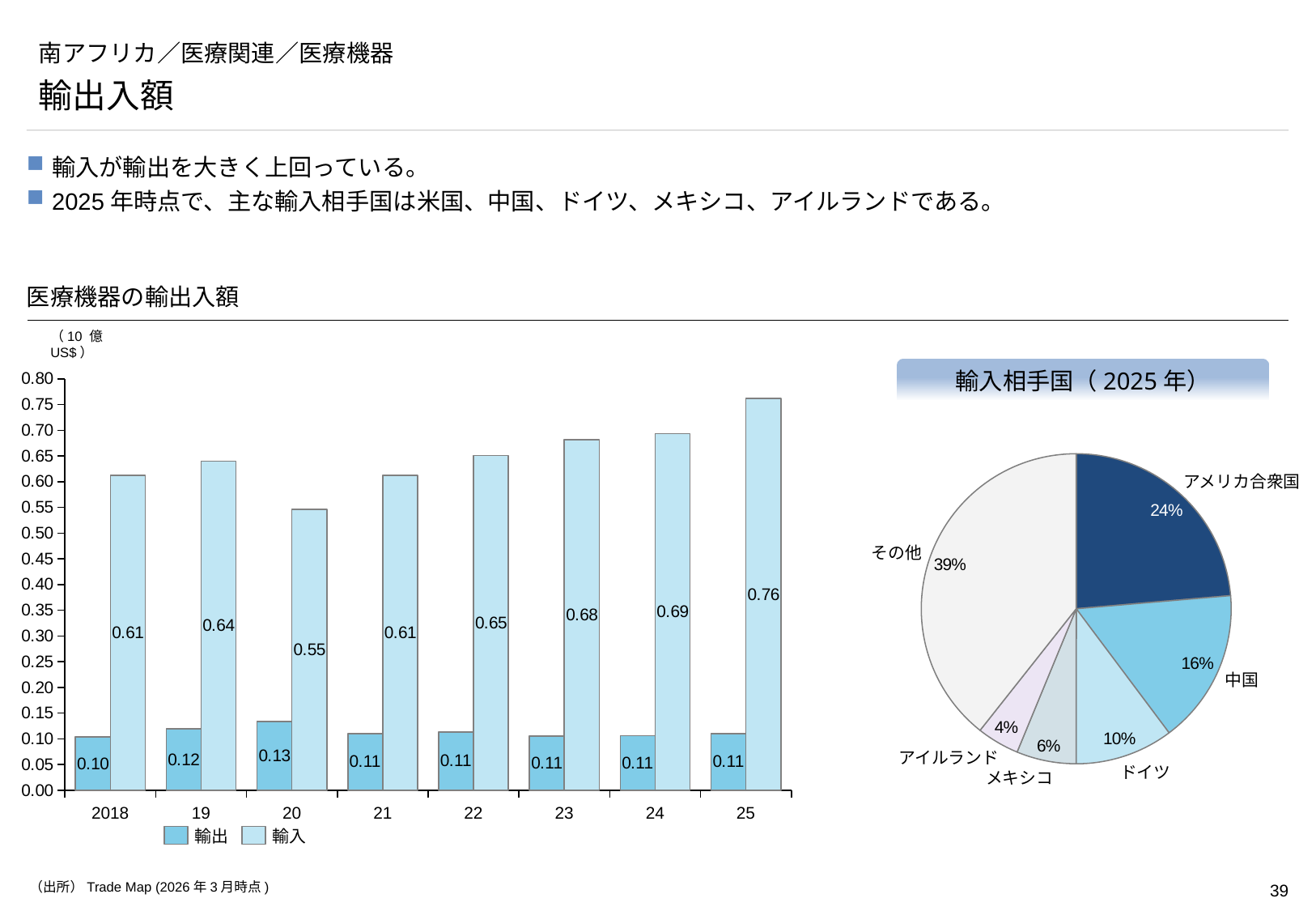
「医療機器の輸出入額」のグラフで、2021年から2025年にかけて輸入は増加していますか、減少していますか。 増加 「輸入相手国（2025年）」の円グラフで、最も割合が小さい国はどこですか。 アイルランド 「輸入相手国（2025年）」の円グラフには、いくつの区分がありますか。 6 「医療機器の輸出入額」のグラフは、どの種類のグラフですか。 棒グラフ 「医療機器の輸出入額」のグラフで、輸入が最も多い年はどれですか。 25 「医療機器の輸出入額」のグラフの凡例には、いくつの系列がありますか。 2 「医療機器の輸出入額」のグラフで、2020年の輸出の値はいくらですか。 0.13 「輸入相手国（2025年）」の円グラフで、中国の割合は何%ですか。 16% 「医療機器の輸出入額」のグラフで、2025年の輸入と輸出の差はいくらですか。 0.65 「医療機器の輸出入額」のグラフで、輸入が最も少ない年はどれですか。 20 「医療機器の輸出入額」のグラフで、2025年の輸入の値はいくらですか。 0.76 「医療機器の輸出入額」のグラフで、2019年の輸入と2021年の輸入ではどちらが大きいですか。 2019年の輸入